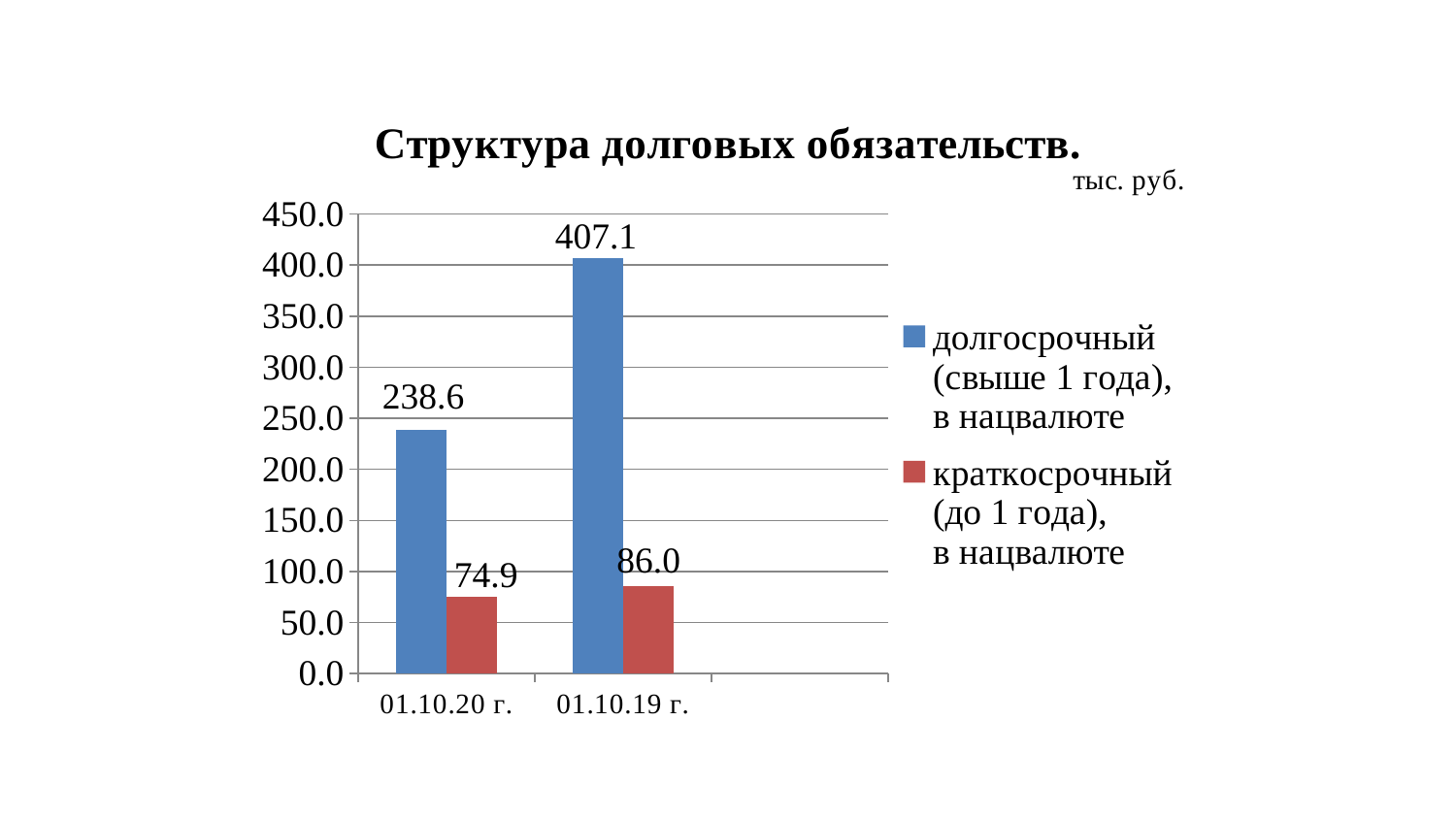
How many dates (categories) are shown on the x axis? 2 Which date has the lowest value for краткосрочный (до 1 года), в нацвалюте? 01.10.20 г. Which is larger: долгосрочный for 01.10.20 г. or краткосрочный for 01.10.19 г.? долгосрочный for 01.10.20 г. Which date has the highest value for долгосрочный (свыше 1 года), в нацвалюте? 01.10.19 г. What is the difference between the долгосрочный values for 01.10.19 г. and 01.10.20 г.? 168.5 What is the value of долгосрочный (свыше 1 года), в нацвалюте for 01.10.19 г.? 407.1 What is the value of долгосрочный (свыше 1 года), в нацвалюте for 01.10.20 г.? 238.6 How many series does the legend list? 2 What is the value of краткосрочный (до 1 года), в нацвалюте for 01.10.19 г.? 86.0 What is the value of краткосрочный (до 1 года), в нацвалюте for 01.10.20 г.? 74.9 What is the title of the chart? Структура долговых обязательств. What kind of chart is shown on the slide? bar chart